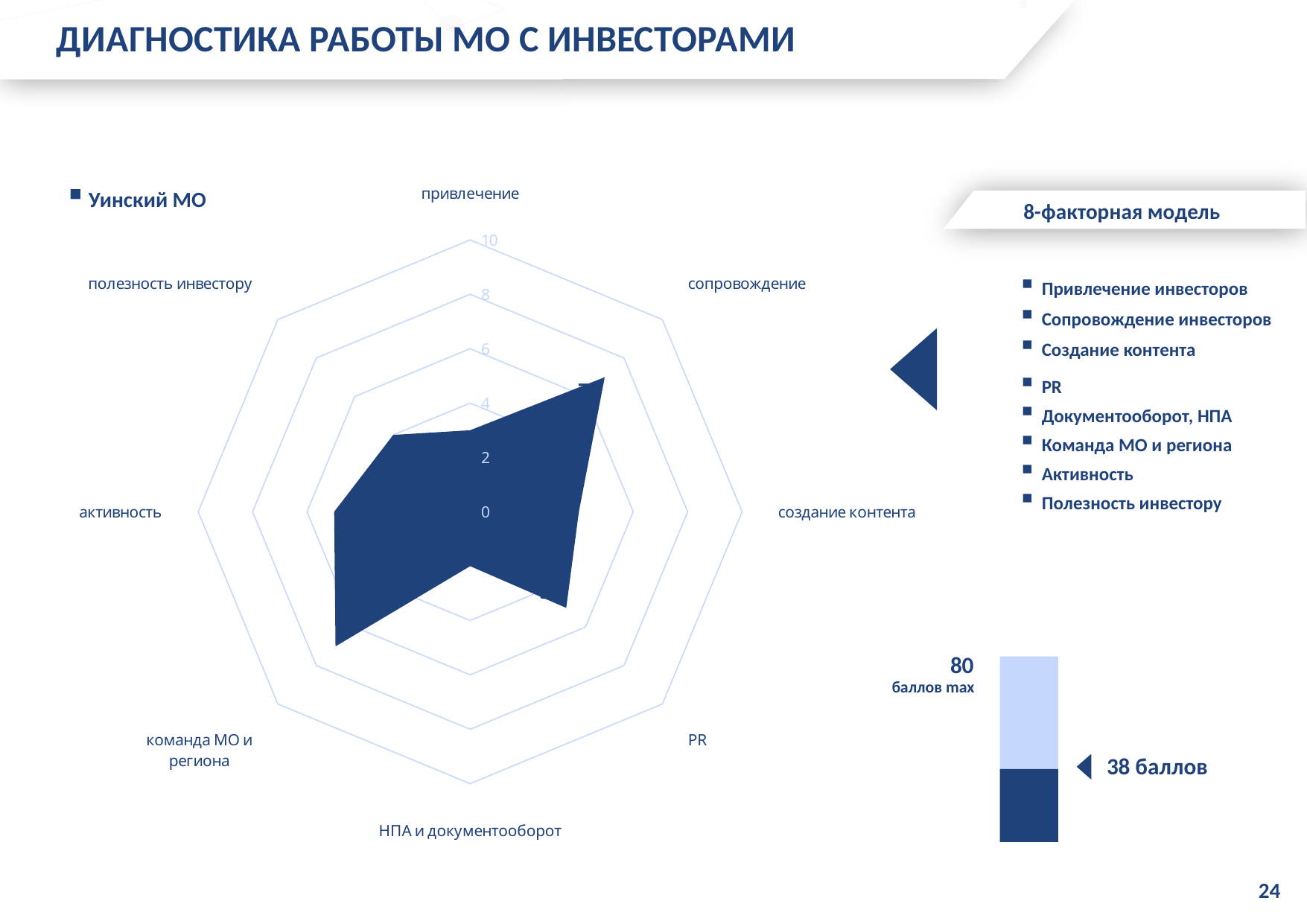
Is the value for PR greater or less than 8? less Which has the larger value, сопровождение or НПА и документооборот? сопровождение How many categories (axes) does the radar chart have? 8 Is the value for сопровождение greater or less than 4? greater Is the value for привлечение greater or less than 6? less What is the maximum value shown on the radar chart's scale? 10 Which has the larger value, команда МО и региона or привлечение? команда МО и региона What kind of chart is shown on the left of the slide? radar chart